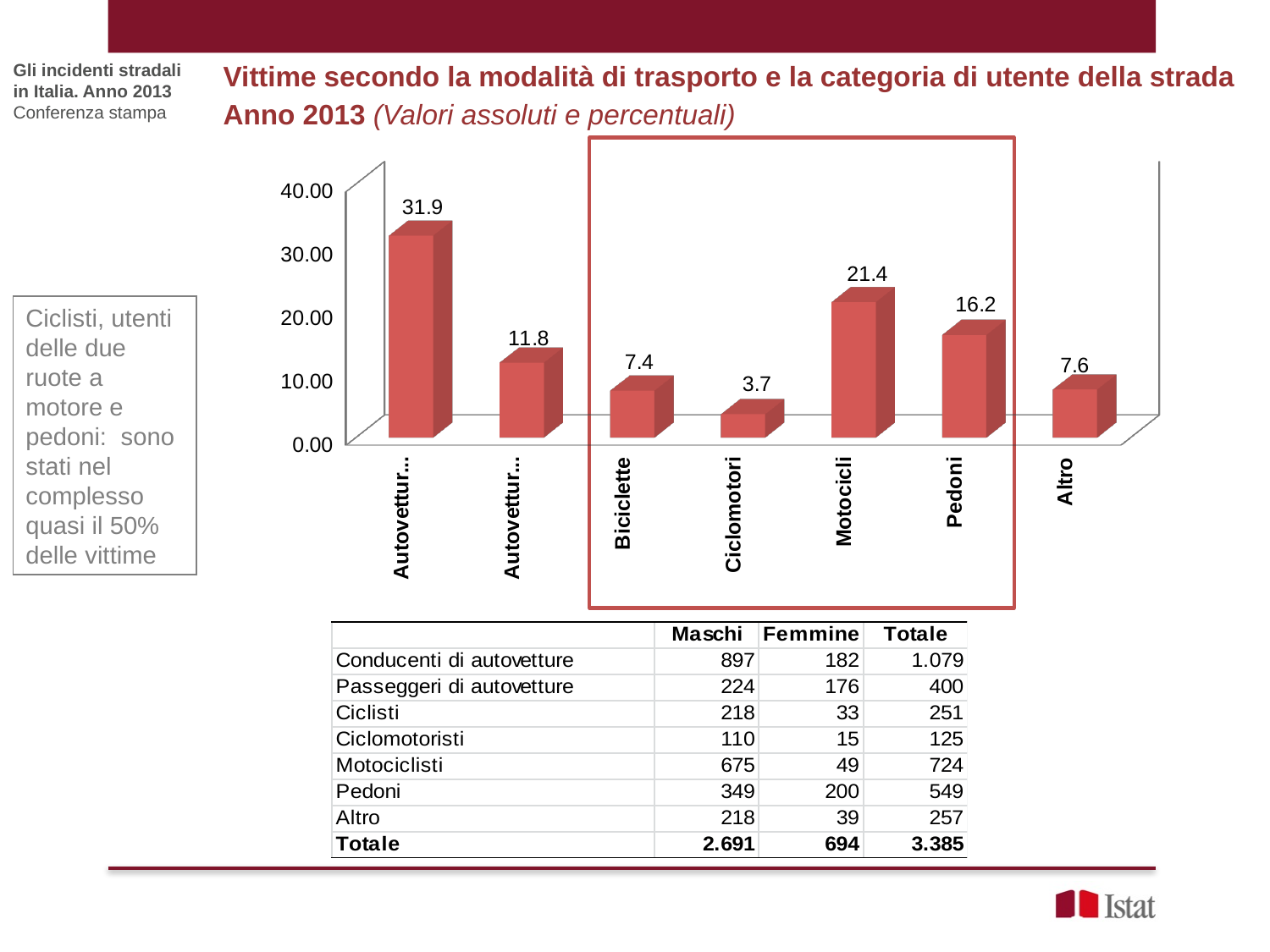
What is the value shown for Biciclette? 7.4 What is the value shown for Ciclomotori? 3.7 What is the value shown for Pedoni? 16.2 Which has the larger value, Biciclette or Altro? Altro Is the value for Motocicli greater or less than 20.00? greater What is the value shown for Motocicli? 21.4 What kind of chart is shown on the slide? bar chart How many categories (bars) are shown in the chart? 7 What is the difference between the values for Motocicli and Pedoni? 5.2 Which category has the lowest value in the chart? Ciclomotori What is the value shown for Altro? 7.6 What is the difference between the values for Pedoni and Biciclette? 8.8